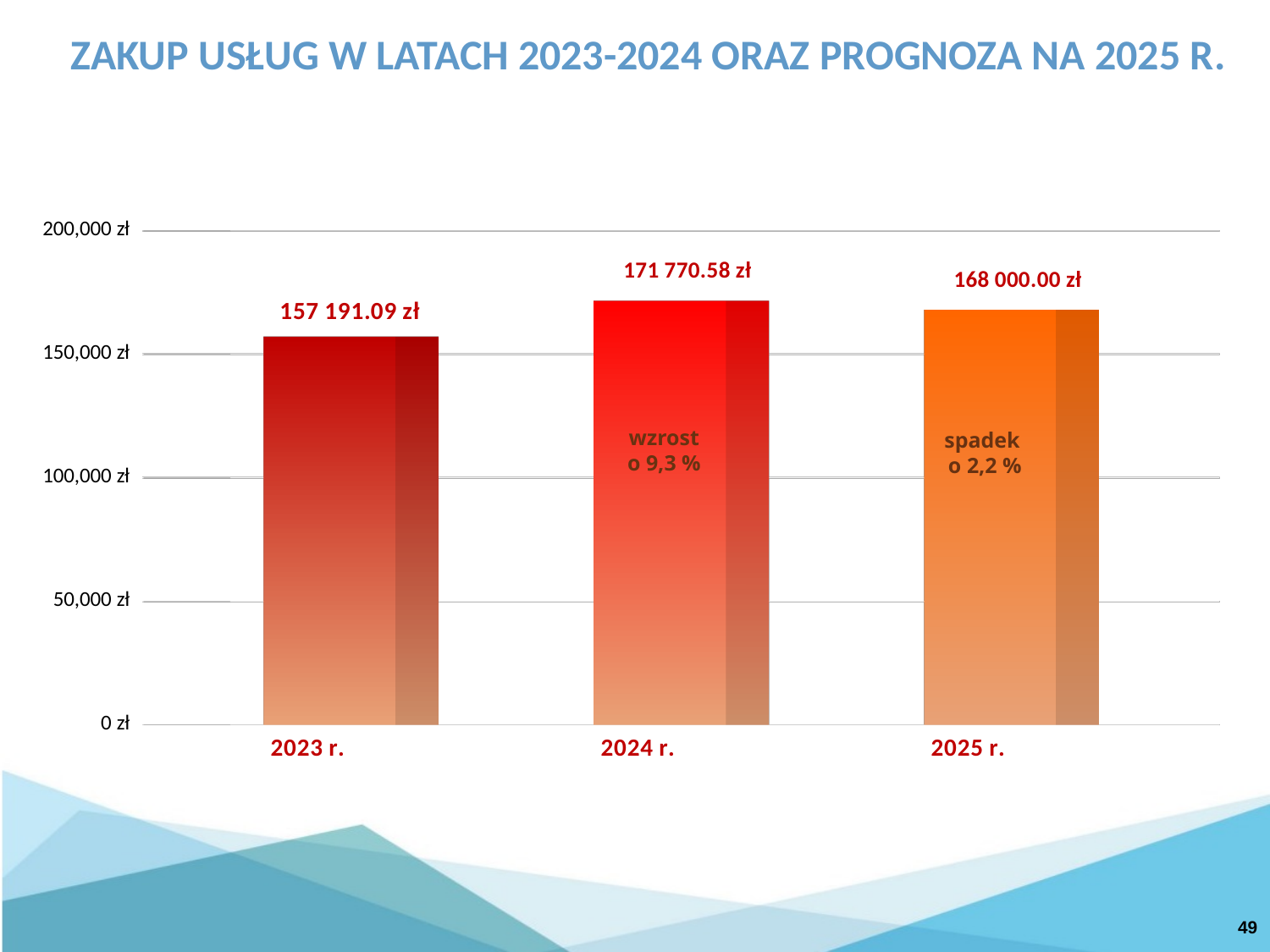
Which year has the highest value? 2024 r. What is the value for 2023 r.? 157 191.09 zł What is the value for 2024 r.? 171 770.58 zł Is the value for 2023 r. greater or less than 150,000 zł? greater Which year has the lowest value? 2023 r. What is the value for 2025 r.? 168 000.00 zł Which is larger, the value for 2025 r. or the value for 2023 r.? 2025 r. How many years are shown on the chart? 3 What is the difference between the values for 2024 r. and 2025 r.? 3 770.58 zł What is the difference between the values for 2024 r. and 2023 r.? 14 579.49 zł What percentage change is annotated on the 2025 r. bar? spadek o 2,2 % What kind of chart is shown on the slide? bar chart